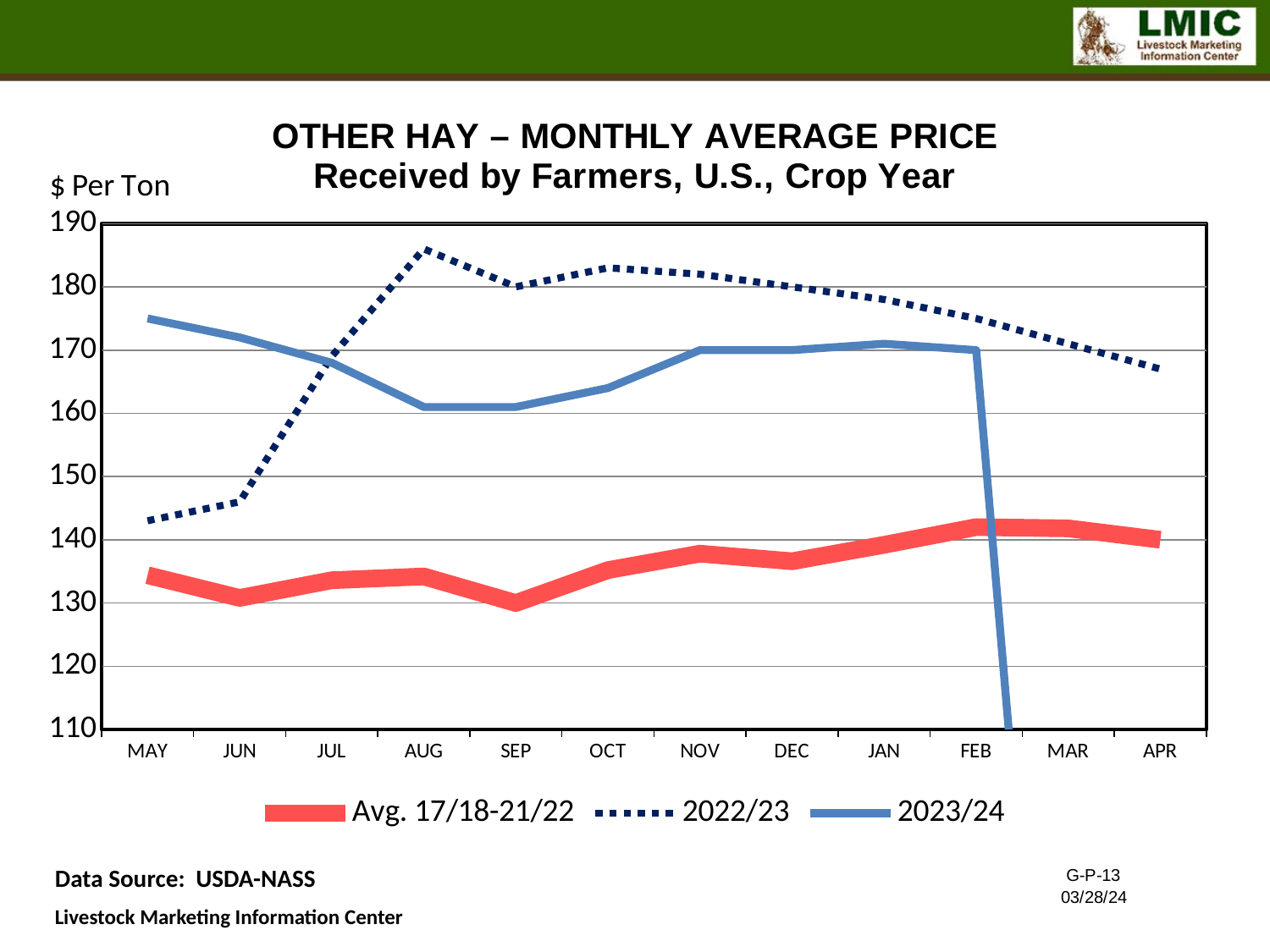
Does the 2022/23 series rise or fall from AUG to APR? fall Is the 2022/23 value for AUG greater or less than 180? greater Is the 2023/24 value for AUG greater or less than 170? less In which month is the 2022/23 series at its lowest value? MAY In MAY, which series has the higher value: 2022/23 or 2023/24? 2023/24 What unit is shown on the y axis of the chart? $ Per Ton In OCT, which series has the higher value: 2022/23 or 2023/24? 2022/23 How many months are shown along the x axis? 12 How many series does the legend list? 3 In which month does the 2022/23 series reach its highest value? AUG What kind of chart is shown on the slide? line chart Is the Avg. 17/18-21/22 value for SEP greater or less than 140? less